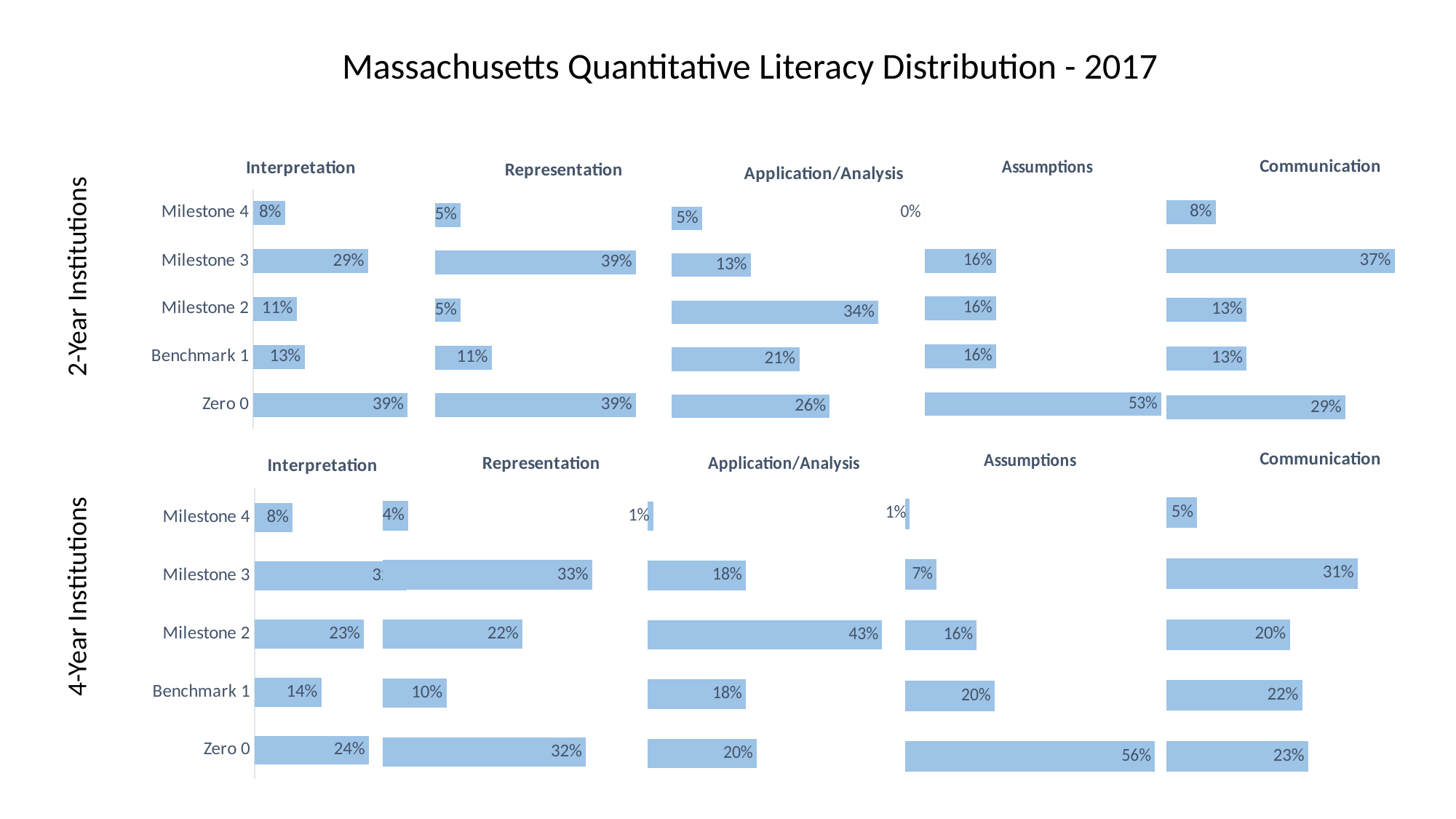
In the 4-Year Institutions Application/Analysis chart, which category has the lowest value? Milestone 4 How many categories are shown in the 4-Year Institutions Communication chart? 5 In the 2-Year Institutions Assumptions chart, what is the value for Milestone 4? 0% In the 2-Year Institutions Interpretation chart, what is the value for Zero 0? 39% In the 2-Year Institutions Application/Analysis chart, which is larger: the value for Milestone 2 or the value for Zero 0? Milestone 2 In the 2-Year Institutions Communication chart, which category has the highest value? Milestone 3 What is the title of the slide's chart group? Massachusetts Quantitative Literacy Distribution - 2017 In the 2-Year Institutions Assumptions chart, what is the difference between the Zero 0 value and the Milestone 3 value? 37% In the 4-Year Institutions Assumptions chart, what is the difference between the Zero 0 value and the Milestone 2 value? 40% In the 4-Year Institutions Application/Analysis chart, what is the value for Milestone 2? 43% In the 4-Year Institutions Representation chart, what is the value for Benchmark 1? 10% What type of chart is the 2-Year Institutions Representation chart? Bar chart